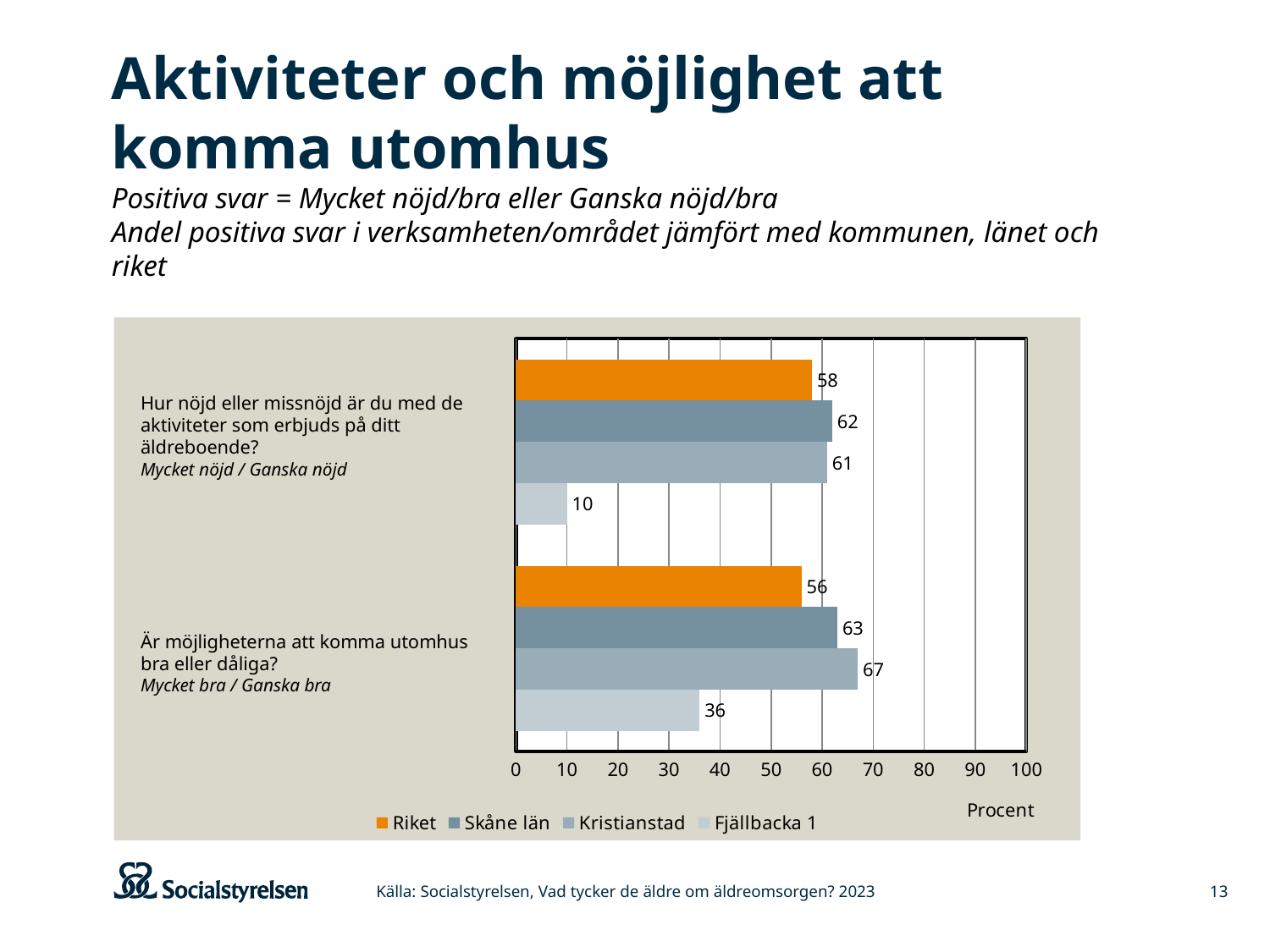
What is the value for Riket for the question about satisfaction with the activities offered? 58 What is the value for Fjällbacka 1 for the question about how satisfied residents are with the activities offered at the care home? 10 What is the value for Kristianstad for the question about whether the opportunities to get outdoors are good or bad? 67 What unit label is shown below the x axis of the chart? Procent Which series has the highest value for the question about opportunities to get outdoors? Kristianstad Which is larger for the question about satisfaction with activities: the value for Skåne län or the value for Riket? Skåne län Which series has the lowest value for the question about satisfaction with the activities offered? Fjällbacka 1 What kind of chart is shown on the slide? Bar chart What is the value for Skåne län for the question about opportunities to get outdoors? 63 What is the difference between the Kristianstad and Fjällbacka 1 values for the question about opportunities to get outdoors? 31 How many series does the legend list? 4 Is the value for Fjällbacka 1 for the question about opportunities to get outdoors greater or less than 40? less